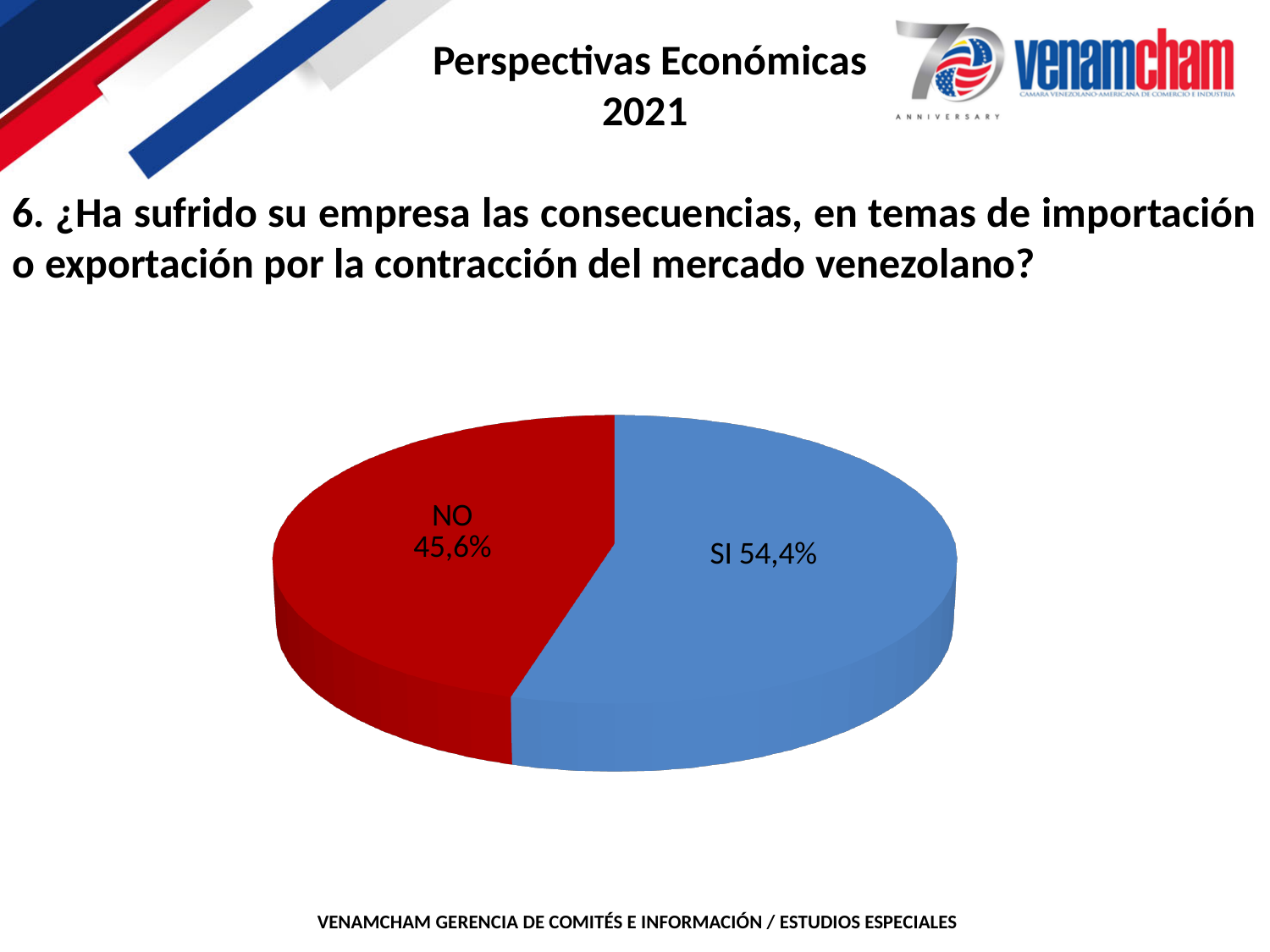
What percentage of respondents answered SI? 54,4% What colour is the NO slice? Red Which is larger, the SI slice or the NO slice? SI How many slices does the pie chart have? 2 What share of the pie does the NO slice represent? 45,6% What kind of chart is shown on the slide? Pie chart Which response has the smallest share of the pie? NO What percentage of respondents answered NO? 45,6% What colour is the SI slice? Blue What is the difference in percentage points between the SI and NO slices? 8,8 Which response has the largest share of the pie? SI